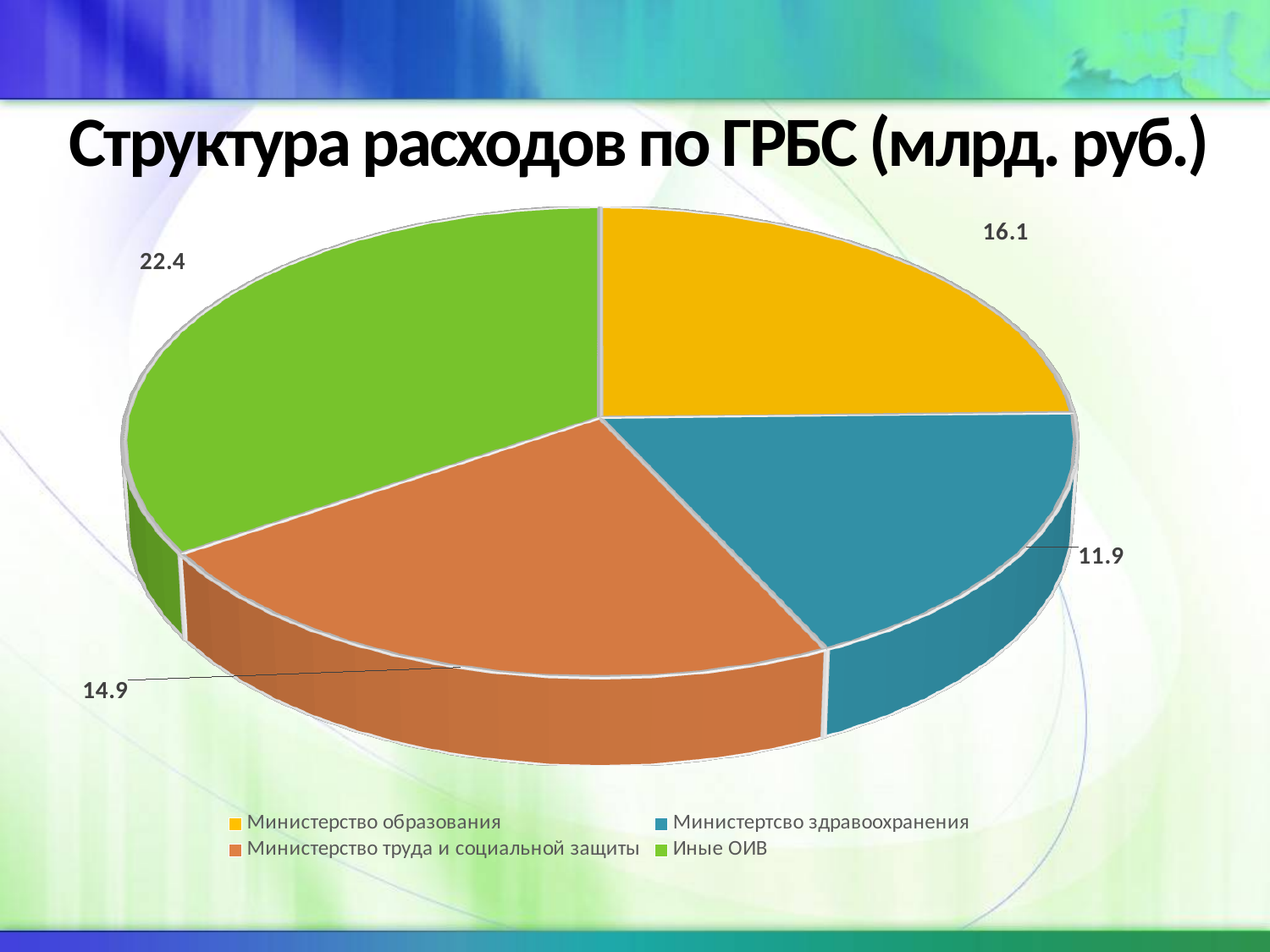
Which is larger, the value for Министерство образования or the value for Министерство труда и социальной защиты? Министерство образования What is the value for Министерство труда и социальной защиты? 14.9 What is the difference between the values for Иные ОИВ and Министерство образования? 6.3 What is the value for Иные ОИВ? 22.4 Which category has the largest value? Иные ОИВ What type of chart is shown on the slide? Pie chart What is the total of all the values shown in the pie chart? 65.3 What is the title of the chart? Структура расходов по ГРБС (млрд. руб.) Which category has the smallest value? Министертсво здравоохранения What is the value for Министерство образования? 16.1 What is the value for Министертсво здравоохранения? 11.9 How many categories does the pie chart have? 4